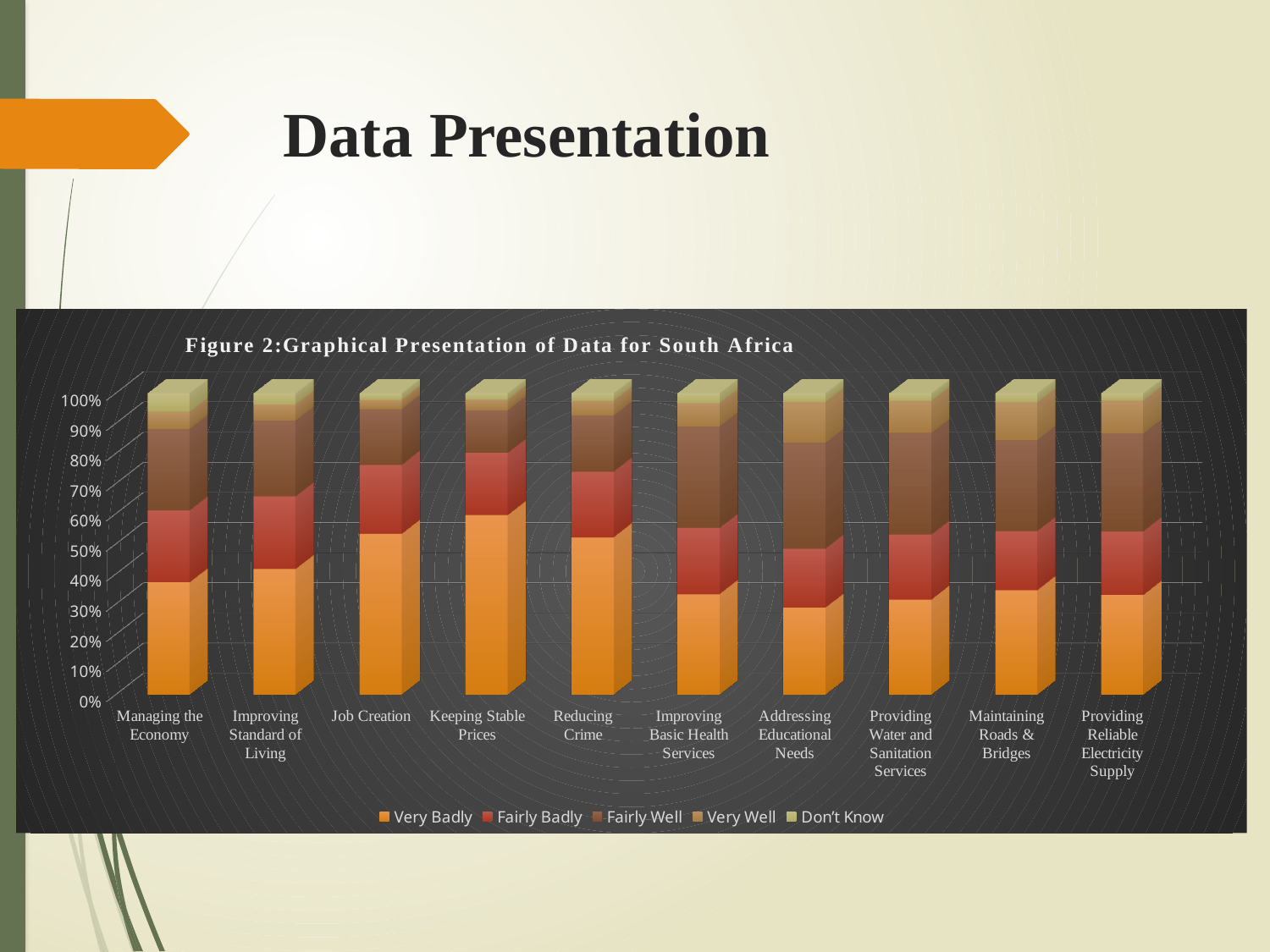
Is the 'Very Badly' value for Keeping Stable Prices greater or less than 50%? greater How many categories are shown along the x axis of the chart? 10 Is the 'Very Badly' value for Managing the Economy greater or less than 50%? less How many series does the chart's legend list? 5 Which has the larger 'Very Badly' segment, Keeping Stable Prices or Managing the Economy? Keeping Stable Prices Which has the larger 'Very Badly' segment, Job Creation or Addressing Educational Needs? Job Creation What kind of chart is shown on the slide? Stacked bar chart What is the title of the chart? Figure 2:Graphical Presentation of Data for South Africa Which series is shown in orange at the bottom of each bar? Very Badly Is the 'Very Badly' value for Job Creation greater or less than 50%? greater Which category has the largest 'Very Badly' segment? Keeping Stable Prices